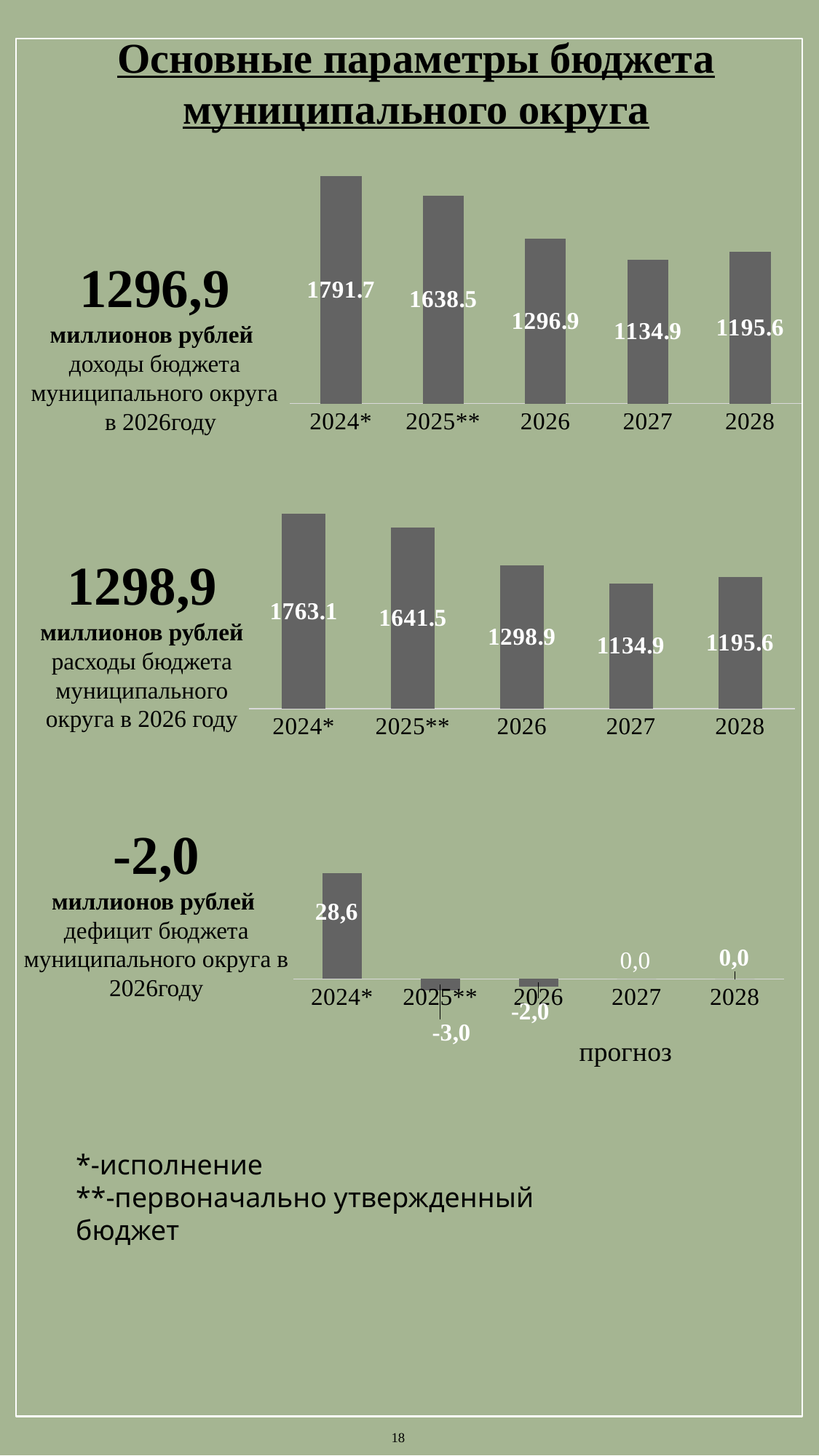
In the top chart (budget revenues), how many bars are plotted? 5 In the middle chart (budget expenditures), what is the difference between the 2028 and 2027 values? 60.7 In the bottom chart (budget deficit), what is the value for 2024*? 28,6 What type of chart is the bottom chart (budget deficit)? bar chart In the top chart (budget revenues), what is the difference between the 2024* and 2025** values? 153.2 In the middle chart (budget expenditures), is the value for 2027 or 2028 larger? 2028 In the middle chart (budget expenditures), what is the value for 2026? 1298.9 In the bottom chart (budget deficit), what is the value for 2025**? -3,0 In the top chart (budget revenues), do the values rise or fall from 2024* to 2027? fall In the top chart (budget revenues), which year has the lowest value? 2027 In the middle chart (budget expenditures), which year has the highest value? 2024* In the top chart (budget revenues), what is the value for 2024*? 1791.7